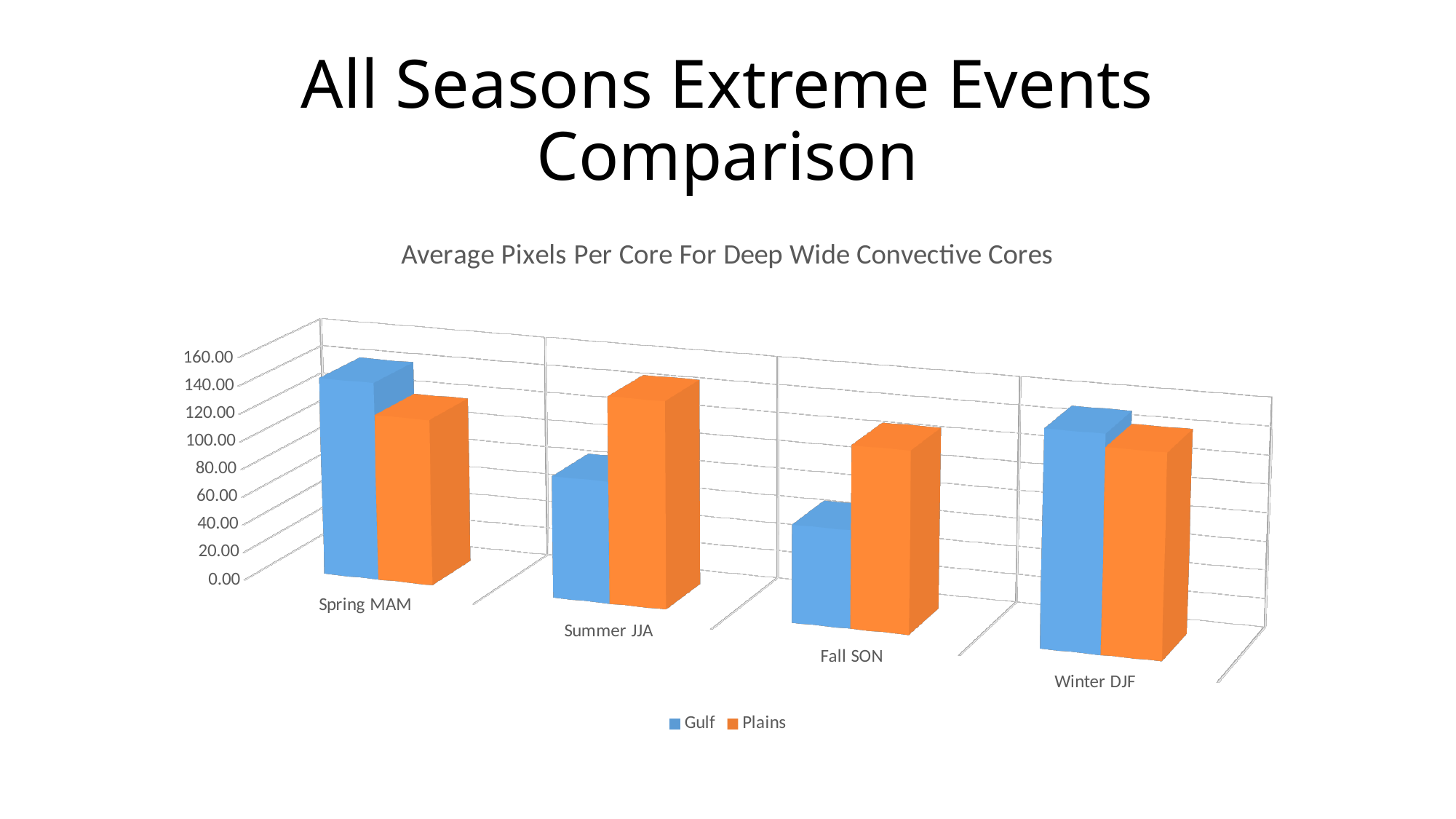
For Fall SON, which is larger, Gulf or Plains? Plains Which series is shown in orange? Plains Is the Gulf value for Fall SON greater or less than 80.00? less What is the title of the chart? Average Pixels Per Core For Deep Wide Convective Cores How many seasons (categories) are shown on the x axis? 4 What kind of chart is shown on the slide? bar chart Which season has the highest Plains value? Summer JJA For Spring MAM, which is larger, Gulf or Plains? Gulf How many series does the legend list? 2 Is the Gulf value for Spring MAM greater or less than 100.00? greater Which season has the lowest Gulf value? Fall SON For Summer JJA, which is larger, Gulf or Plains? Plains